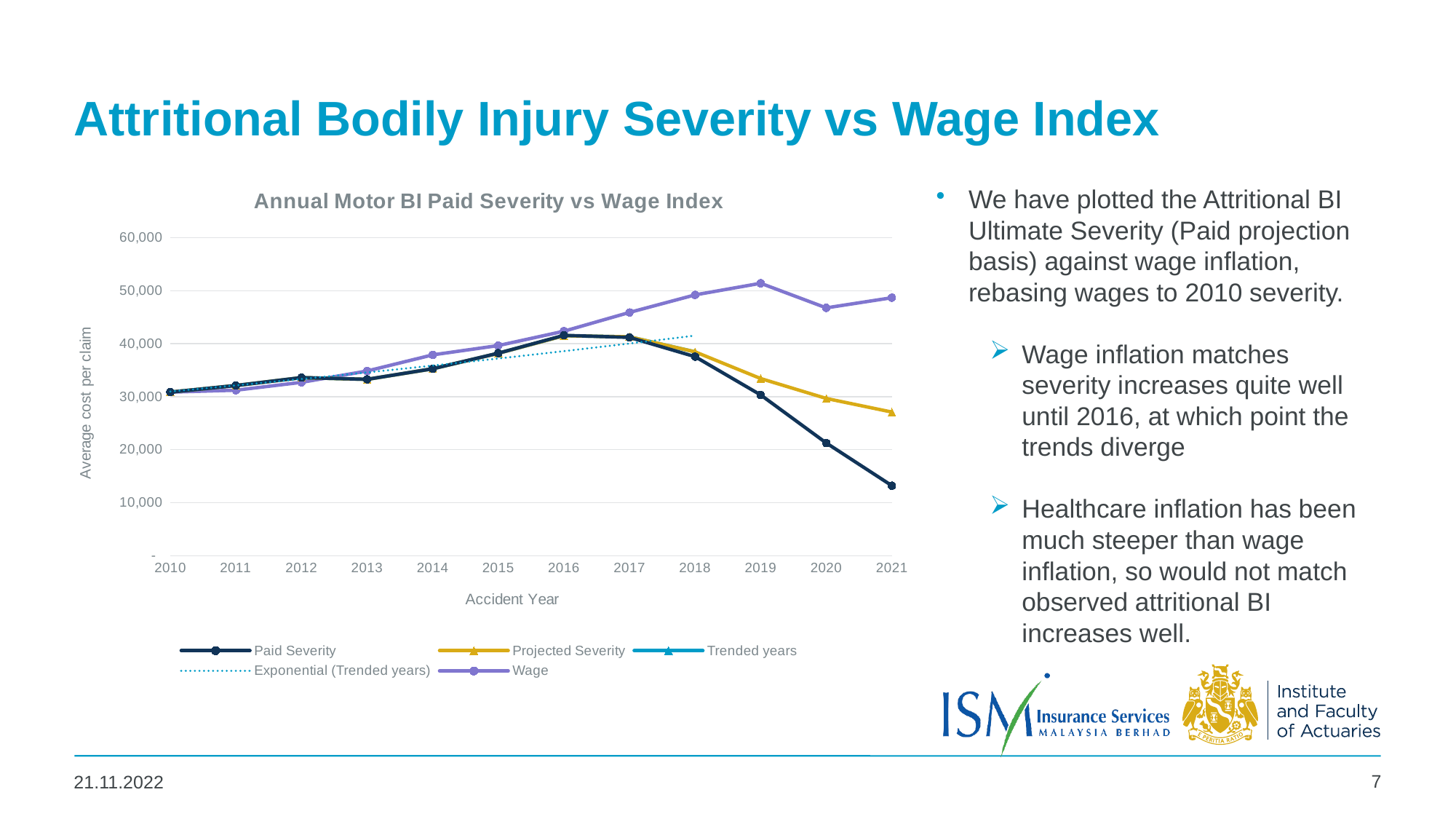
In which accident year is Paid Severity at its lowest? 2021 Is the Projected Severity value for 2021 greater or less than 30,000? less Which is larger in 2021, the Wage value or the Paid Severity value? Wage What is the label of the vertical axis? Average cost per claim Is the Wage value for 2019 greater or less than 50,000? greater What kind of chart is shown on the slide? line chart What is the title of the chart? Annual Motor BI Paid Severity vs Wage Index Does Paid Severity rise or fall from 2018 to 2021? fall How many accident years are plotted along the x axis? 12 Is the Paid Severity value for 2021 greater or less than 20,000? less In which accident year does the Wage series reach its highest value? 2019 How many series does the chart legend list? 5